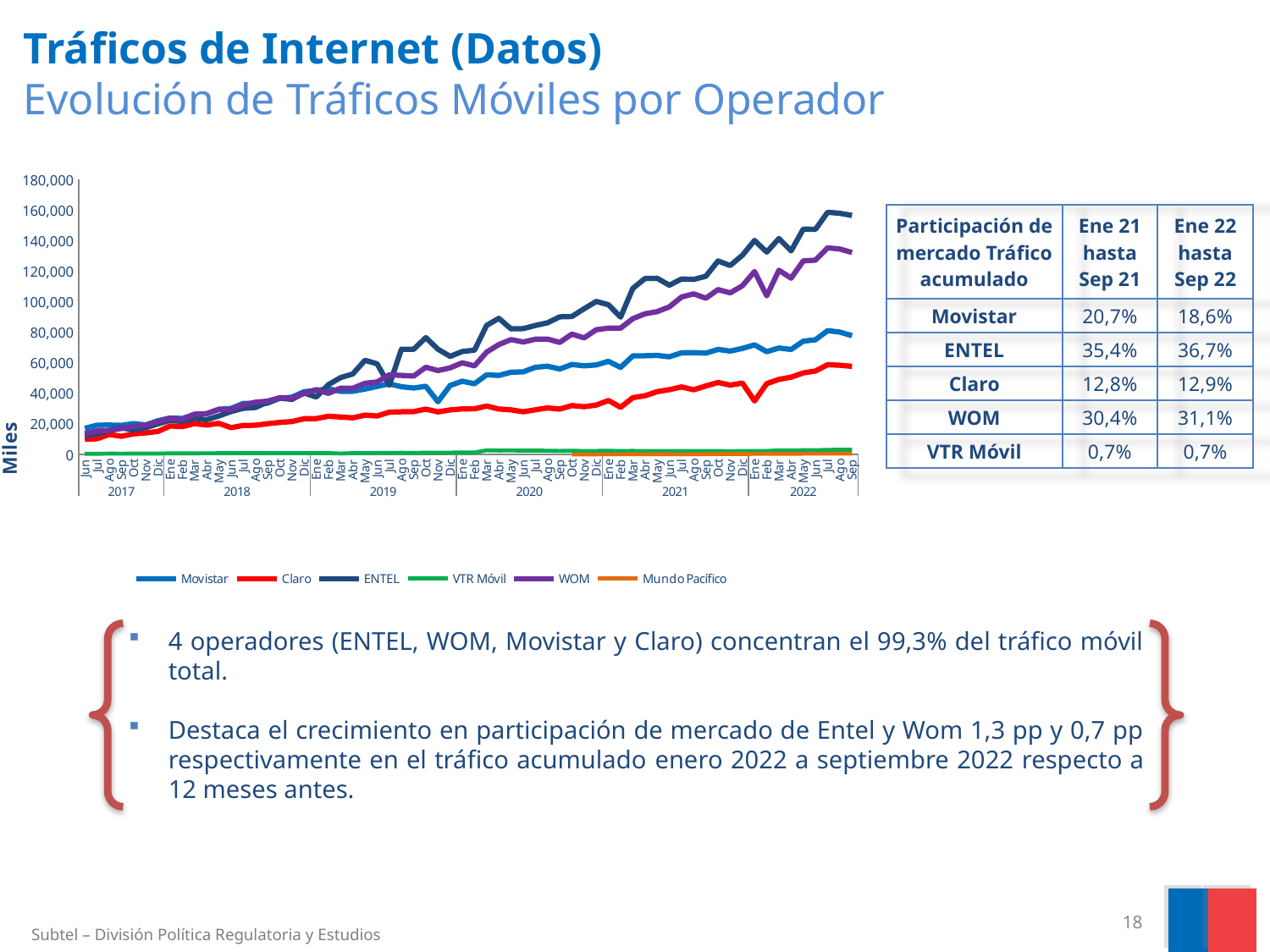
Is the value for Movistar in Sep 2022 greater or less than 60,000? greater Is the value for ENTEL in Sep 2022 greater or less than 140,000? greater How many years are labelled along the x axis of the chart? 6 Which is larger in Sep 2022, the value for ENTEL or the value for Claro? ENTEL Is the value for Claro in Sep 2022 greater or less than 80,000? less What kind of chart is shown on the slide? line chart Does the ENTEL line rise or fall over the period shown? rise What is the label on the vertical axis of the chart? Miles Which is larger in Sep 2022, the value for WOM or the value for Movistar? WOM How many series does the chart legend list? 6 Which operator has the highest mobile traffic at the end of the series (Sep 2022)? ENTEL